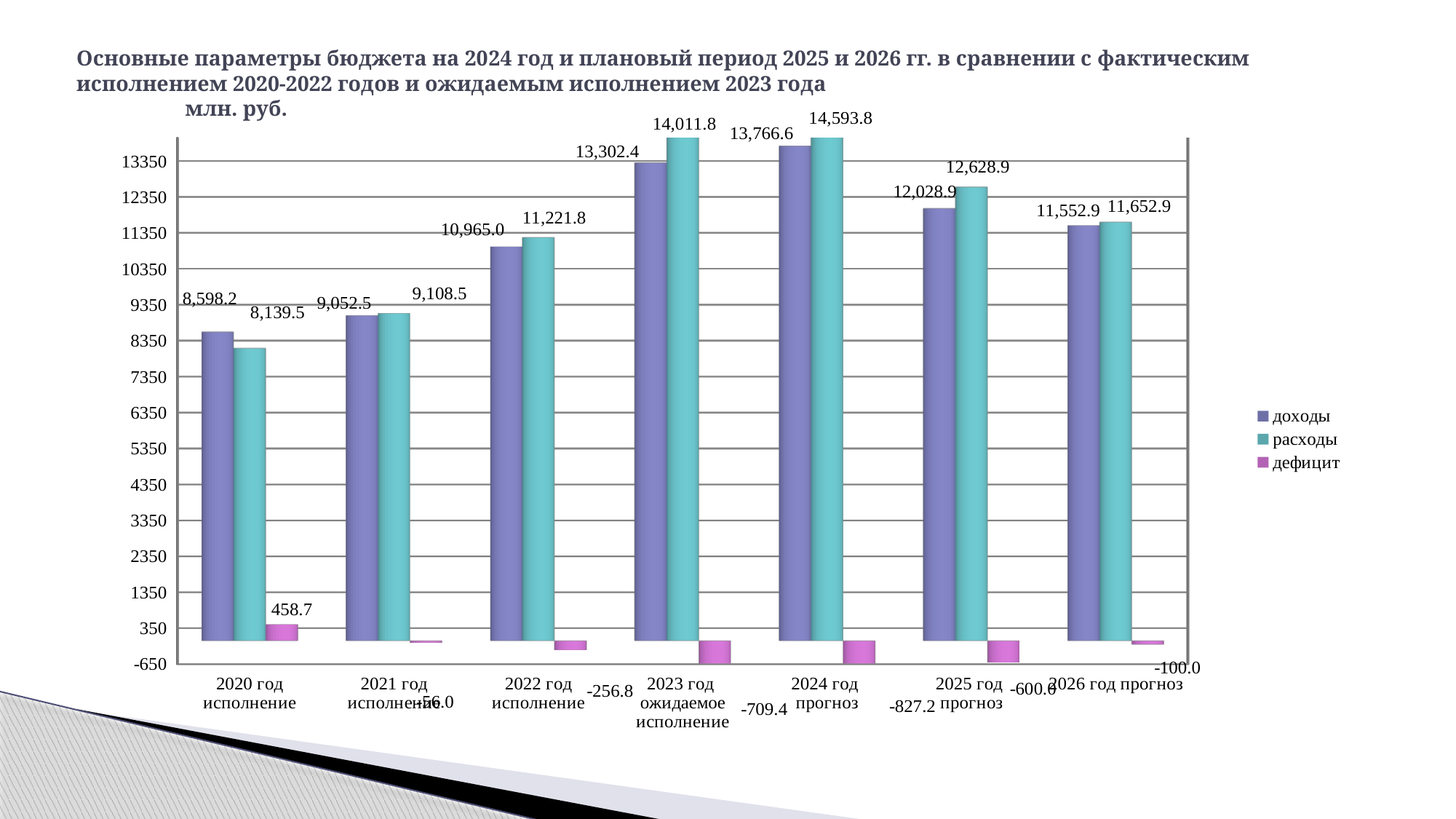
Which year has the lowest value of доходы? 2020 год исполнение How many year categories are shown on the x axis? 7 What is the difference between расходы and доходы for 2023 год ожидаемое исполнение? 709.4 What is the value of доходы for 2020 год исполнение? 8,598.2 What unit of measurement is stated above the chart? млн. руб. Which is larger for 2020 год исполнение, доходы or расходы? доходы Which year has the highest value of расходы? 2024 год прогноз What type of chart is shown on the slide? bar chart How many series does the legend list? 3 What is the value of дефицит for 2020 год исполнение? 458.7 What is the value of доходы for 2026 год прогноз? 11,552.9 What is the value of расходы for 2024 год прогноз? 14,593.8